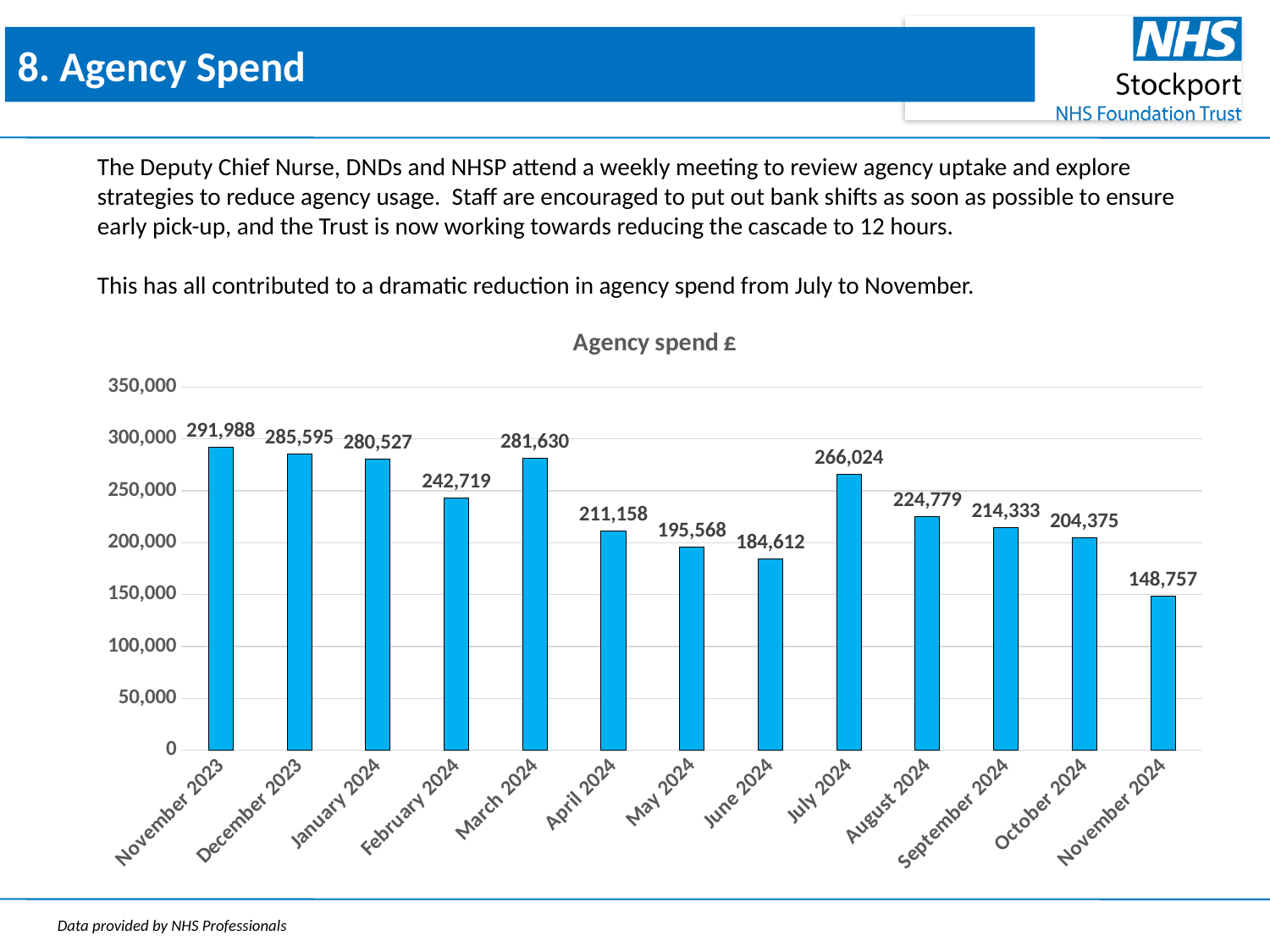
Which month has the lowest agency spend? November 2024 What is the agency spend for July 2024? 266,024 What is the agency spend for February 2024? 242,719 Is the agency spend for September 2024 greater or less than 200,000? greater What is the agency spend for November 2024? 148,757 What is the title of the chart? Agency spend £ Which month has the larger agency spend, June 2024 or August 2024? August 2024 What kind of chart is used to show agency spend? Bar chart What is the difference in agency spend between July 2024 and November 2024? 117,267 How many months are shown on the chart? 13 Which month has the highest agency spend? November 2023 What is the difference in agency spend between March 2024 and April 2024? 70,472